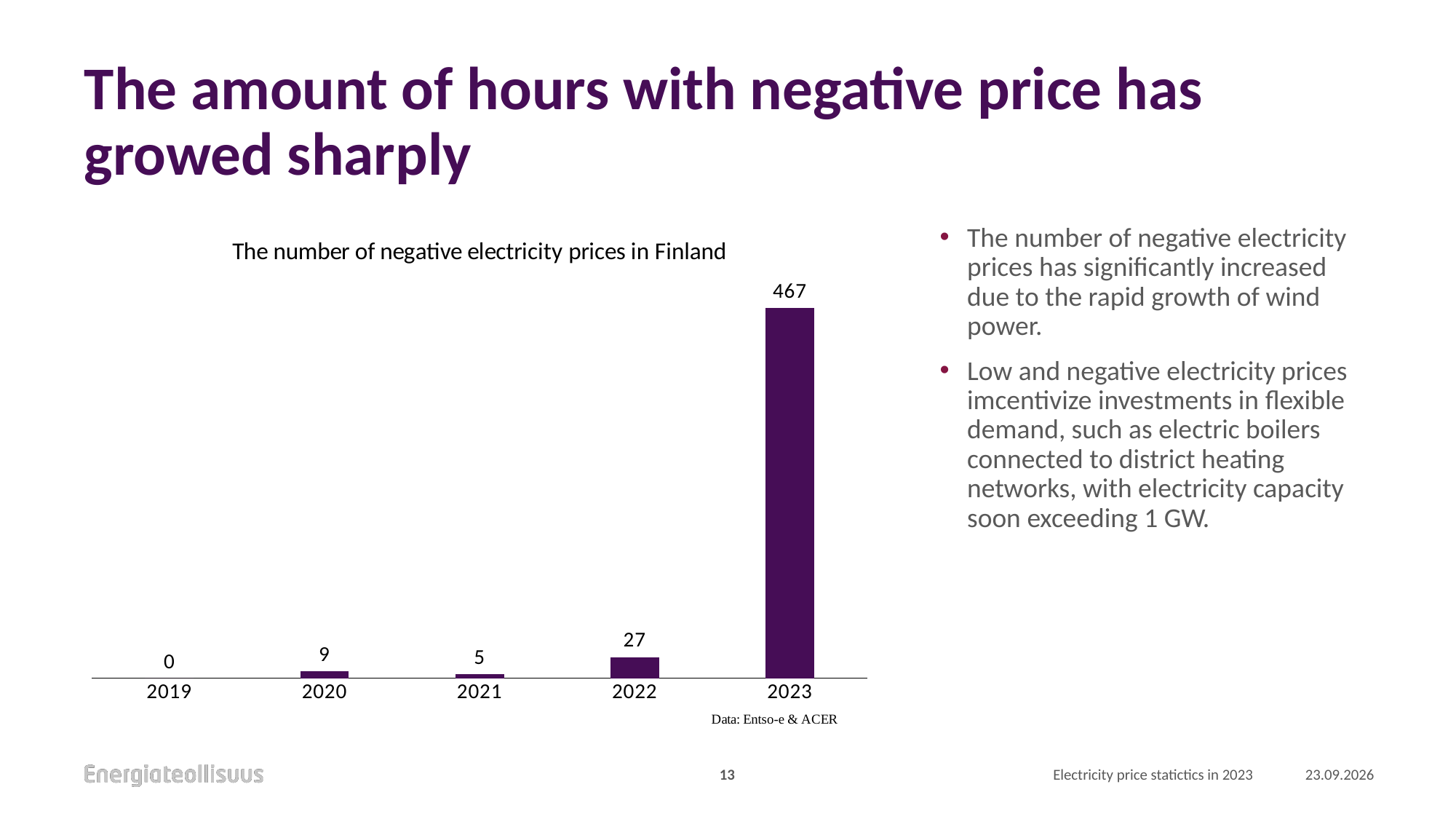
Which year has the highest value? 2023 What kind of chart is this? bar chart What is the value for 2019? 0 What is the difference between the values for 2020 and 2021? 4 What is the title of the chart? The number of negative electricity prices in Finland What is the value for 2020? 9 What is the difference between the values for 2023 and 2022? 440 Which is larger, the value for 2020 or the value for 2021? 2020 What is the value for 2022? 27 Which year has the lowest value? 2019 What is the value for 2023? 467 How many years are shown on the x axis? 5